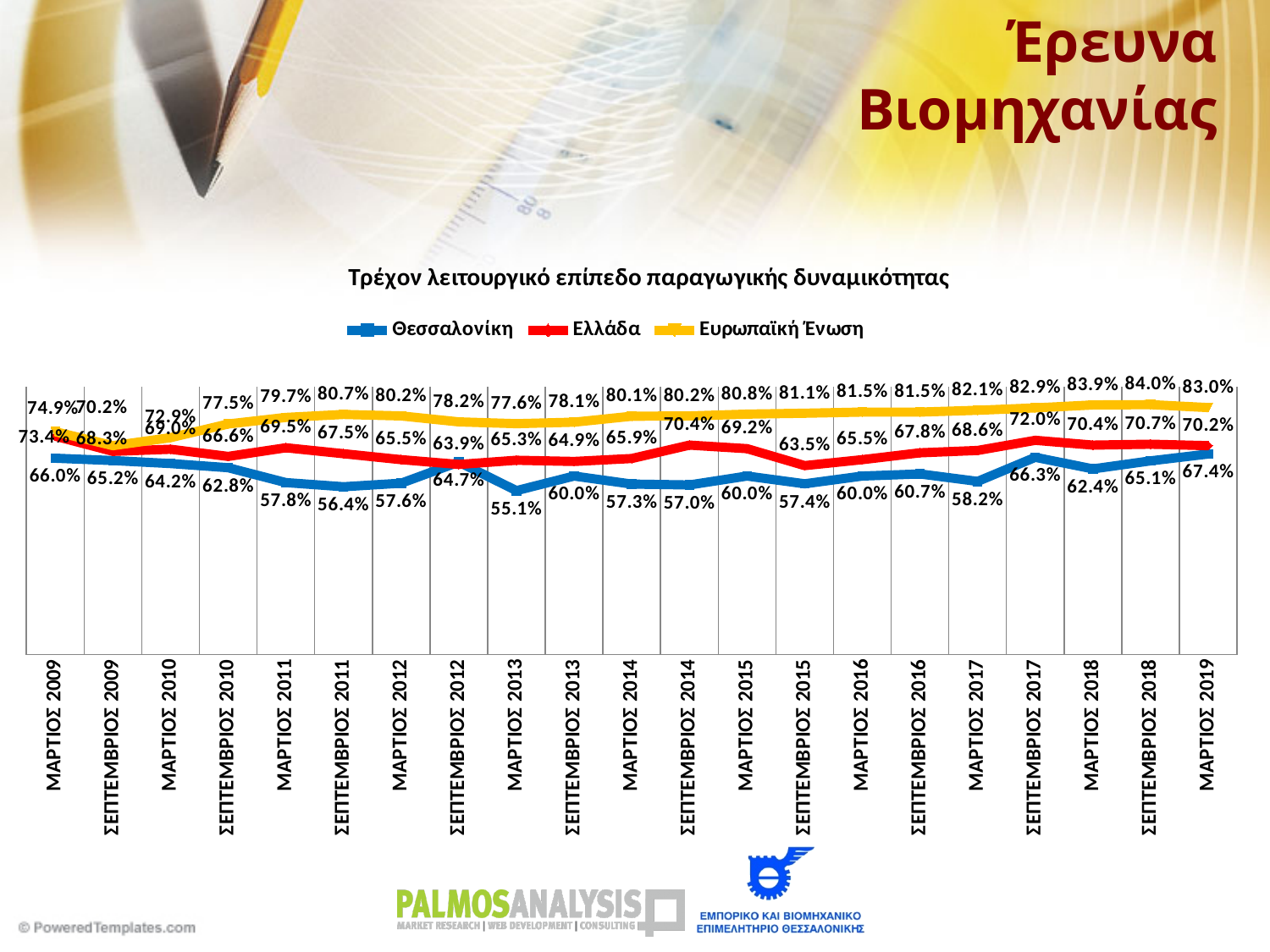
What is the difference between the Ευρωπαϊκή Ένωση and Θεσσαλονίκη values in ΜΑΡΤΙΟΣ 2019? 15.6 percentage points What kind of chart is shown on the slide? line chart What is the value for Ελλάδα in ΣΕΠΤΕΜΒΡΙΟΣ 2017? 72.0% What is the value for Ευρωπαϊκή Ένωση in ΜΑΡΤΙΟΣ 2019? 83.0% In which period does the Ευρωπαϊκή Ένωση series reach its highest value? ΣΕΠΤΕΜΒΡΙΟΣ 2018 How many series does the legend list? 3 How many time points are plotted along the x axis? 21 In which period does the Θεσσαλονίκη series reach its lowest value? ΜΑΡΤΙΟΣ 2013 What is the lowest value of the Ελλάδα series? 63.5% What is the value for Θεσσαλονίκη in ΜΑΡΤΙΟΣ 2013? 55.1% Which colour represents the Ελλάδα series in the legend? red In ΣΕΠΤΕΜΒΡΙΟΣ 2012, which is higher: Ελλάδα or Θεσσαλονίκη? Θεσσαλονίκη